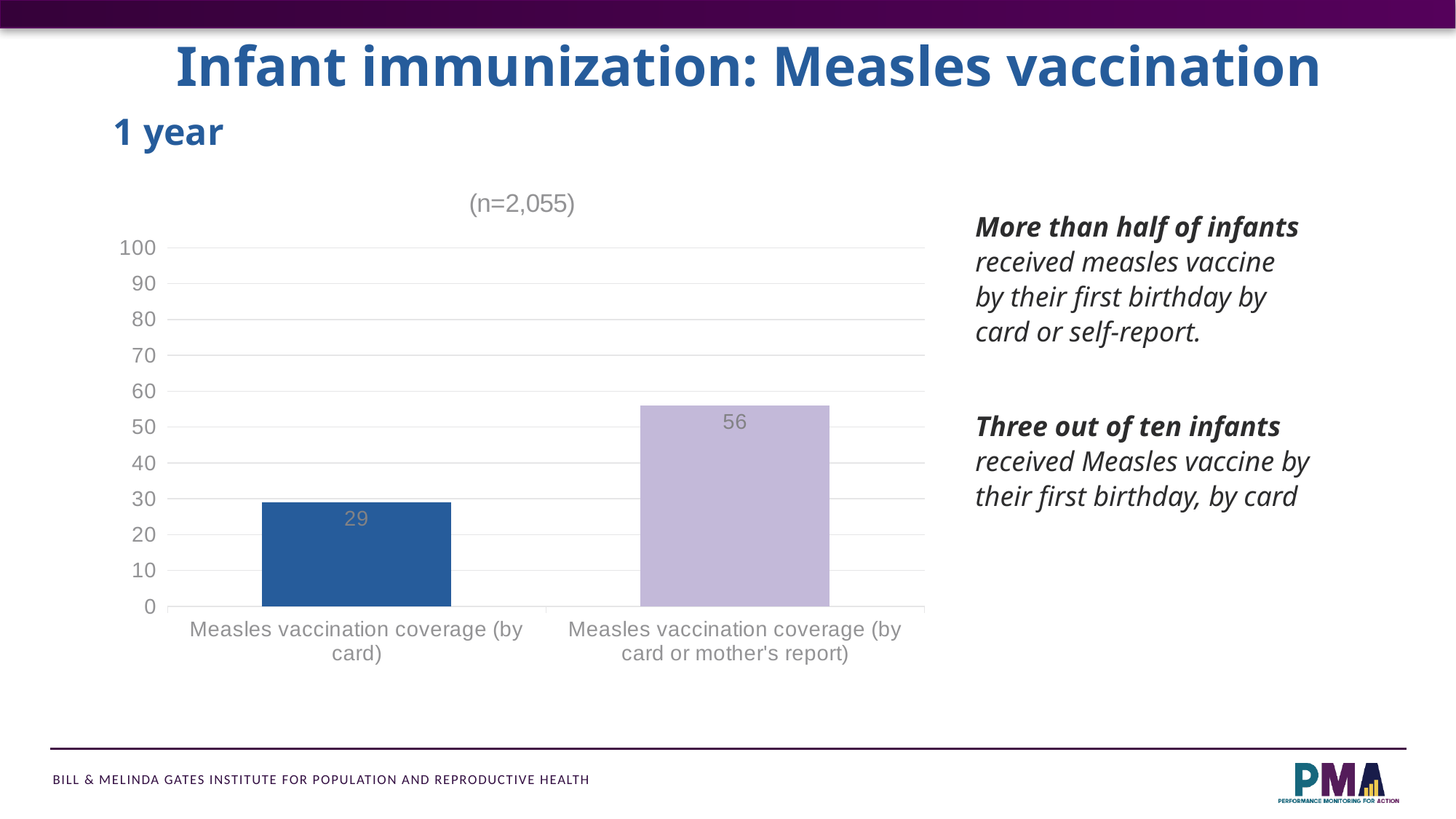
Is the value for Measles vaccination coverage (by card or mother's report) greater or less than 50? greater What is the highest value shown on the vertical axis? 100 Which category has the lowest value? Measles vaccination coverage (by card) Is the value for Measles vaccination coverage (by card) greater or less than 40? less What is the value for Measles vaccination coverage (by card)? 29 What kind of chart is shown on the slide? bar chart How many categories are shown in the chart? 2 What is the value for Measles vaccination coverage (by card or mother's report)? 56 Which is larger: the value for coverage by card or the value for coverage by card or mother's report? Measles vaccination coverage (by card or mother's report) What is the chart's title? (n=2,055) Which category has the highest value? Measles vaccination coverage (by card or mother's report) What is the difference between the value for coverage by card or mother's report and the value for coverage by card? 27